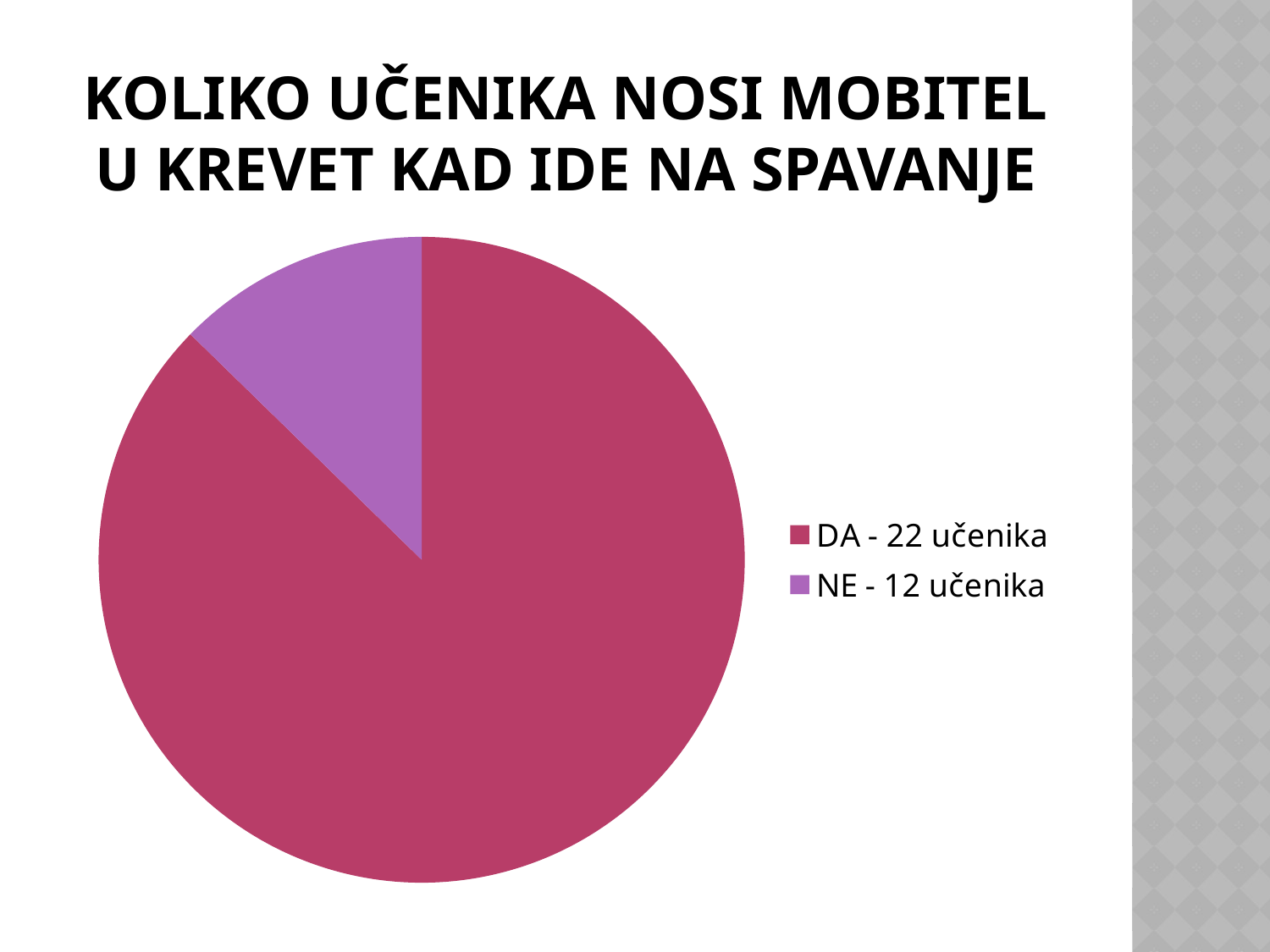
How many slices does the pie chart have? 2 According to the legend, how many more students answered DA than NE? 10 What colour is the slice for DA? dark pink (magenta) What kind of chart is shown on the slide? pie chart Which is larger, the number of students for DA or for NE? DA How many entries does the legend list? 2 According to the legend, how many students answered DA? 22 učenika According to the legend, how many students answered NE? 12 učenika Which category has the larger slice of the pie? DA What colour is the slice for NE? purple Which category has the smaller slice of the pie? NE